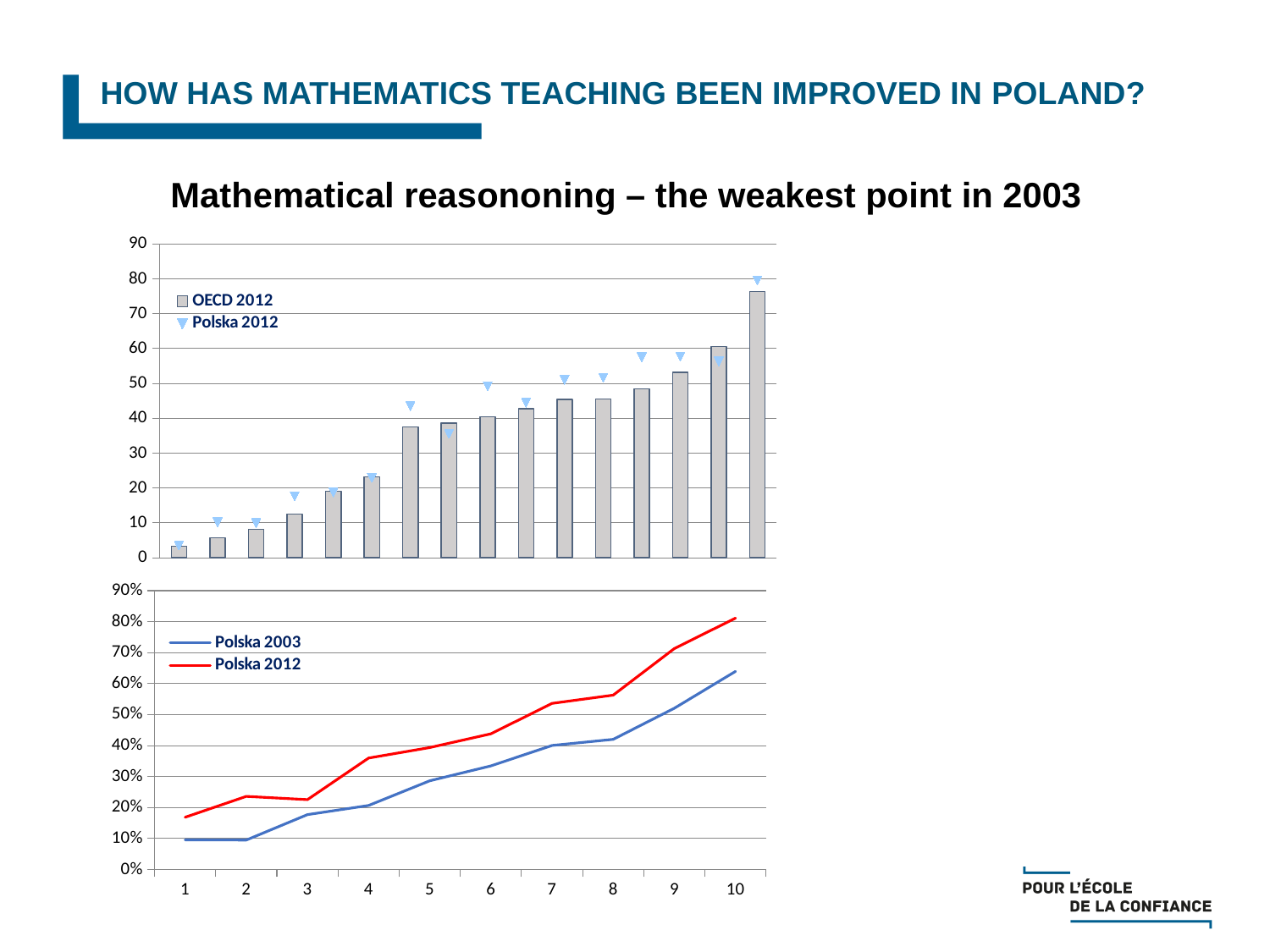
In the top chart, is the tallest OECD 2012 bar greater or less than 70? greater How many series does the legend of the bottom chart list? 2 How many categories are shown on the x axis of the bottom chart? 10 What type of chart is the bottom chart on the slide? line chart In the bottom chart, which series is higher at category 10, Polska 2003 or Polska 2012? Polska 2012 In the top chart, which series is shown with triangle markers? Polska 2012 In the bottom chart, do the Polska 2012 values rise or fall from category 1 to category 10? rise In the bottom chart, is the value for Polska 2003 at category 10 greater or less than 60%? greater In the bottom chart, is the value for Polska 2012 at category 1 greater or less than 20%? less What type of chart is the top chart on the slide? bar chart How many series does the legend of the top chart list? 2